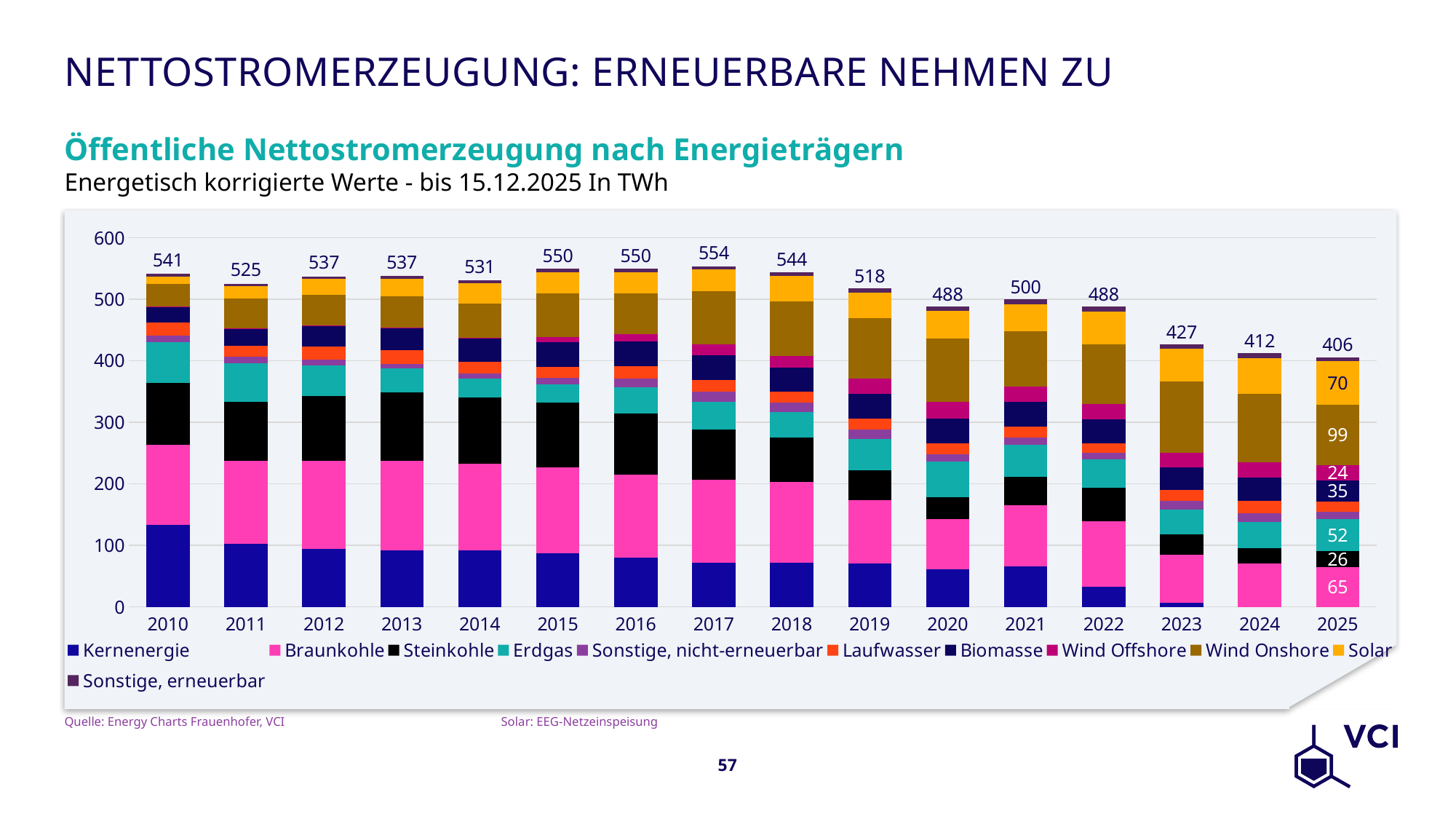
Which year has the highest total net electricity generation? 2017 What is the value of the Solar segment in 2025? 70 What is the value of the Braunkohle segment in 2025? 65 What is the total net electricity generation shown for 2017? 554 What kind of chart is shown on the slide? Stacked bar chart What is the value of the Wind Onshore segment in 2025? 99 How many years are shown on the x axis? 16 How many series does the legend list? 11 Which year has the lowest total net electricity generation? 2025 Which is larger, the total for 2019 or the total for 2021? 2019 What is the difference between the total for 2010 and the total for 2025? 135 What is the total value labelled above the bar for 2025? 406